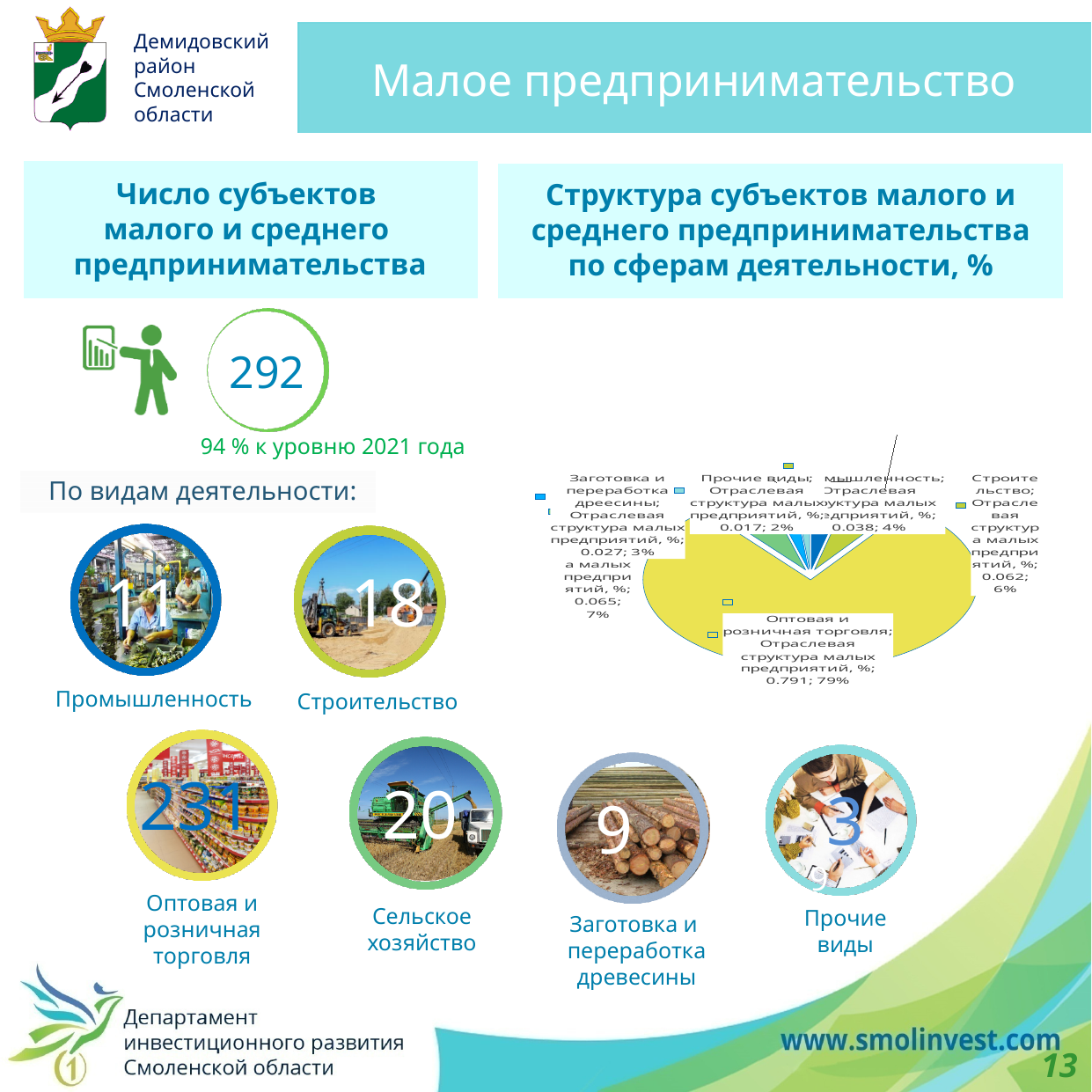
In the pie chart, what share is labelled for 'Строительство'? 6% Which slice of the pie chart is the smallest? Прочие виды In the pie chart, what share is labelled for 'Прочие виды'? 2% What is the decimal value printed in the label for 'Оптовая и розничная торговля' in the pie chart? 0.791 In the pie chart, what share is labelled for 'Оптовая и розничная торговля'? 79% What kind of chart is shown under the title 'Структура субъектов малого и среднего предпринимательства по сферам деятельности, %'? Pie chart Which slice of the pie chart is the largest? Оптовая и розничная торговля In the pie chart, which is larger: the share for 'Строительство' or for 'Промышленность'? Строительство In the pie chart, what is the difference in percentage points between the share for 'Оптовая и розничная торговля' and the share for 'Строительство'? 73 How many slices does the pie chart have? 6